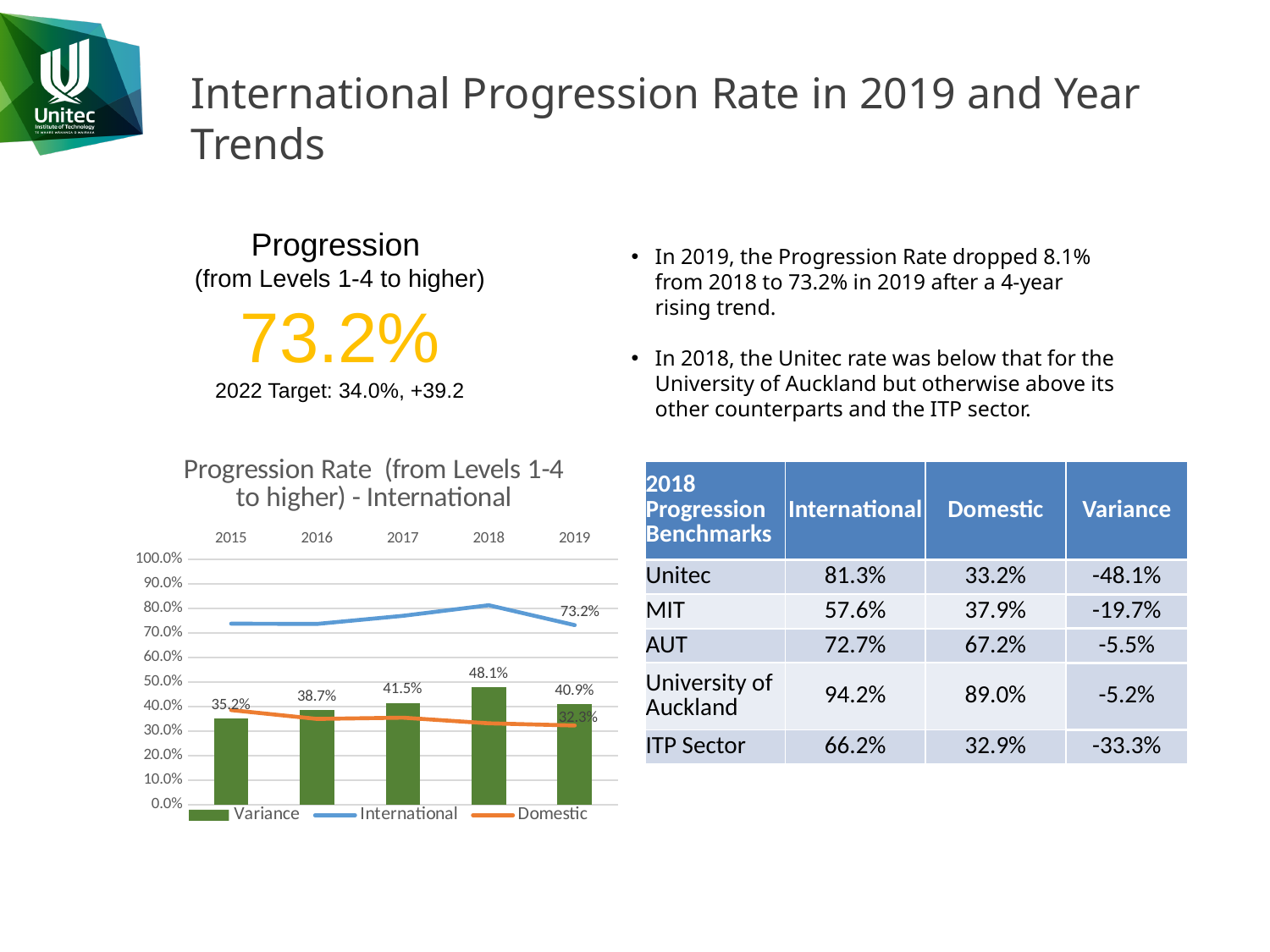
What is the difference between the Variance values for 2018 and 2017? 6.6% In which year is the Variance bar highest? 2018 In which year is the Variance bar lowest? 2015 What is the Variance value for 2018 in the Progression Rate chart? 48.1% Which year has the larger Variance value, 2016 or 2017? 2017 Does the International line rise or fall from 2018 to 2019? fall What is the Domestic progression rate for 2019 shown on the chart? 32.3% How many series does the chart legend list? 3 What is the International progression rate for 2019 shown on the chart? 73.2% Is the International value for 2015 greater or less than 60.0%? greater How many years are shown on the x axis of the chart? 5 What is the Variance value for 2015 in the Progression Rate chart? 35.2%